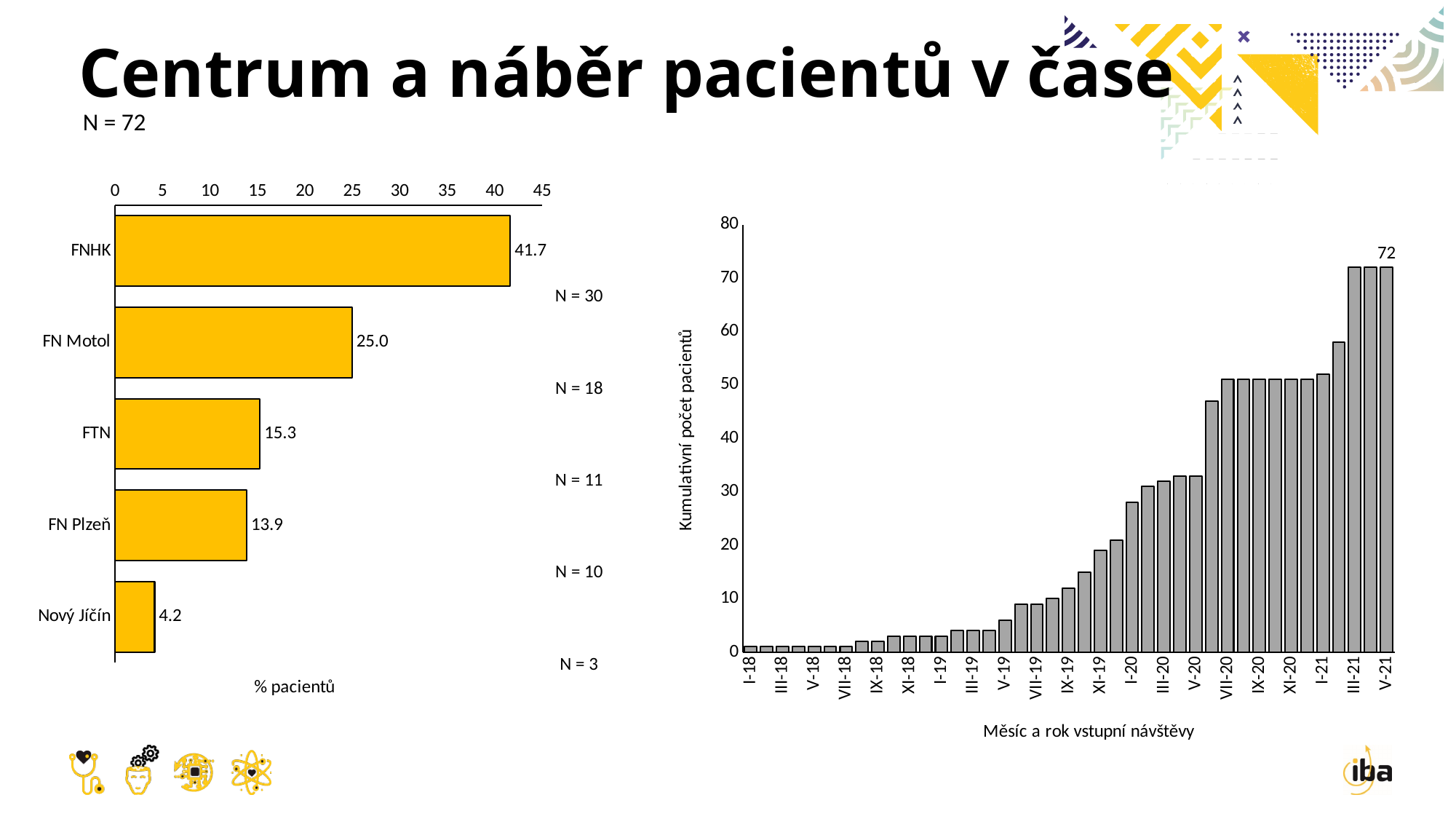
In the left chart (% pacientů), what is the value for FN Plzeň? 13.9 In the left chart (% pacientů), how many centres are shown? 5 In the right chart (Kumulativní počet pacientů), what is the cumulative number of patients at V-21? 72 In the left chart (% pacientů), what is the value for FNHK? 41.7 What kind of chart is the right chart (Kumulativní počet pacientů)? bar chart In the right chart (Kumulativní počet pacientů), is the value for I-20 greater or less than 30? less In the right chart (Kumulativní počet pacientů), do the values rise or fall along the x axis? rise In the left chart (% pacientů), which centre has the highest percentage of patients? FNHK In the left chart (% pacientů), which is larger, the value for FTN or the value for FN Plzeň? FTN In the left chart (% pacientů), what is the difference between the values for FN Motol and FTN? 9.7 In the left chart (% pacientů), what N is shown next to the FN Motol bar? N = 18 In the left chart (% pacientů), which centre has the lowest percentage of patients? Nový Jíčín